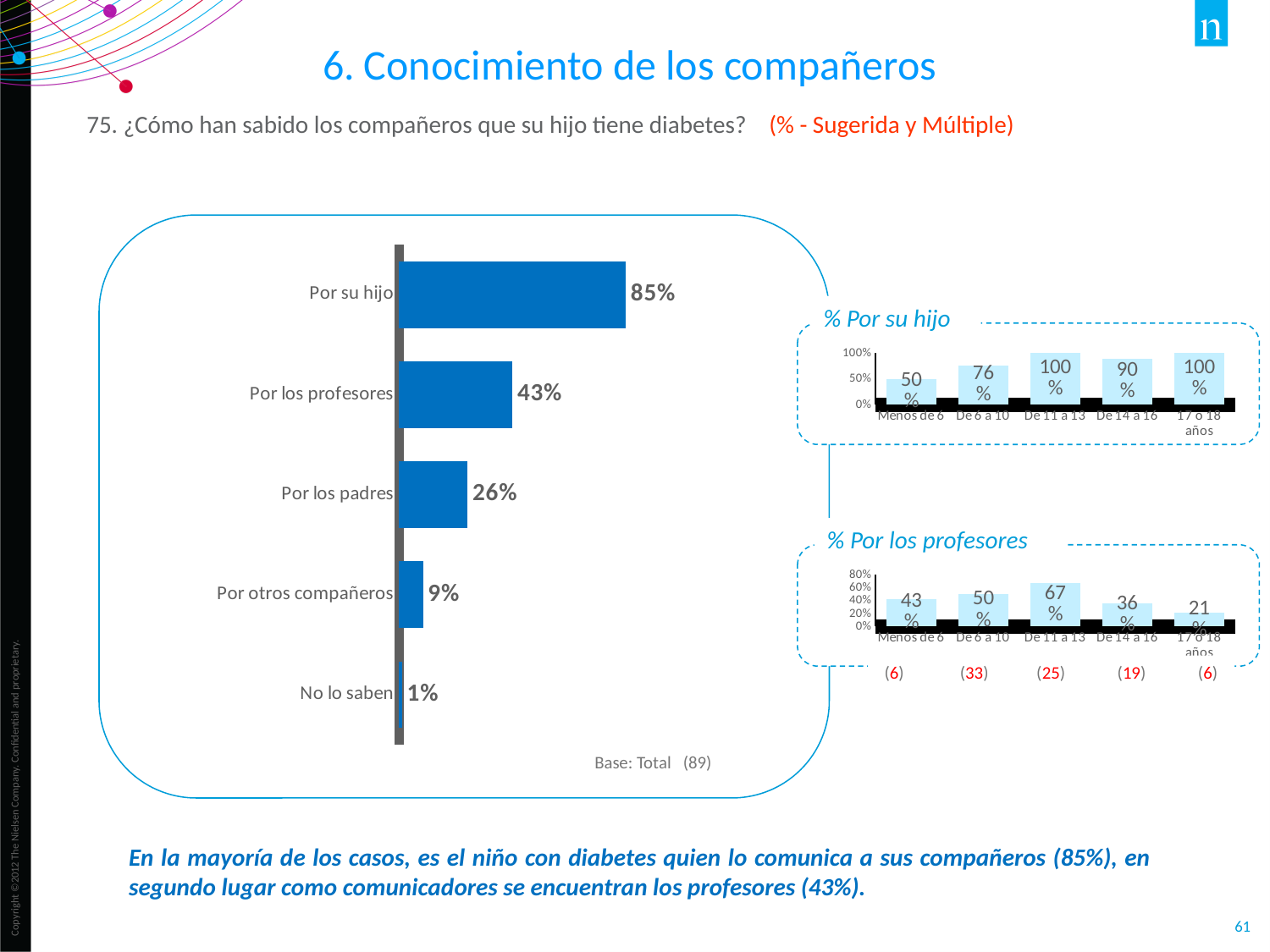
In the main bar chart on the left, what is the value for 'Por los padres'? 26% In the '% Por su hijo' chart, what is the value for 'De 6 a 10'? 76% In the '% Por su hijo' chart, what is the value for 'De 14 a 16'? 90% In the main bar chart on the left, how many categories are shown? 5 In the '% Por los profesores' chart, which age group has the highest value? De 11 a 13 In the main bar chart on the left, which category has the lowest value? No lo saben In the '% Por los profesores' chart, which is larger: the value for 'Menos de 6' or the value for 'De 14 a 16'? Menos de 6 What type of chart is the main chart on the left? Bar chart In the main bar chart on the left, what is the difference between 'Por su hijo' and 'Por los profesores'? 42% In the '% Por los profesores' chart, what is the value for '17 ó 18 años'? 21% In the main bar chart on the left, what is the value for 'Por su hijo'? 85% In the '% Por su hijo' chart, which age group has the lowest value? Menos de 6